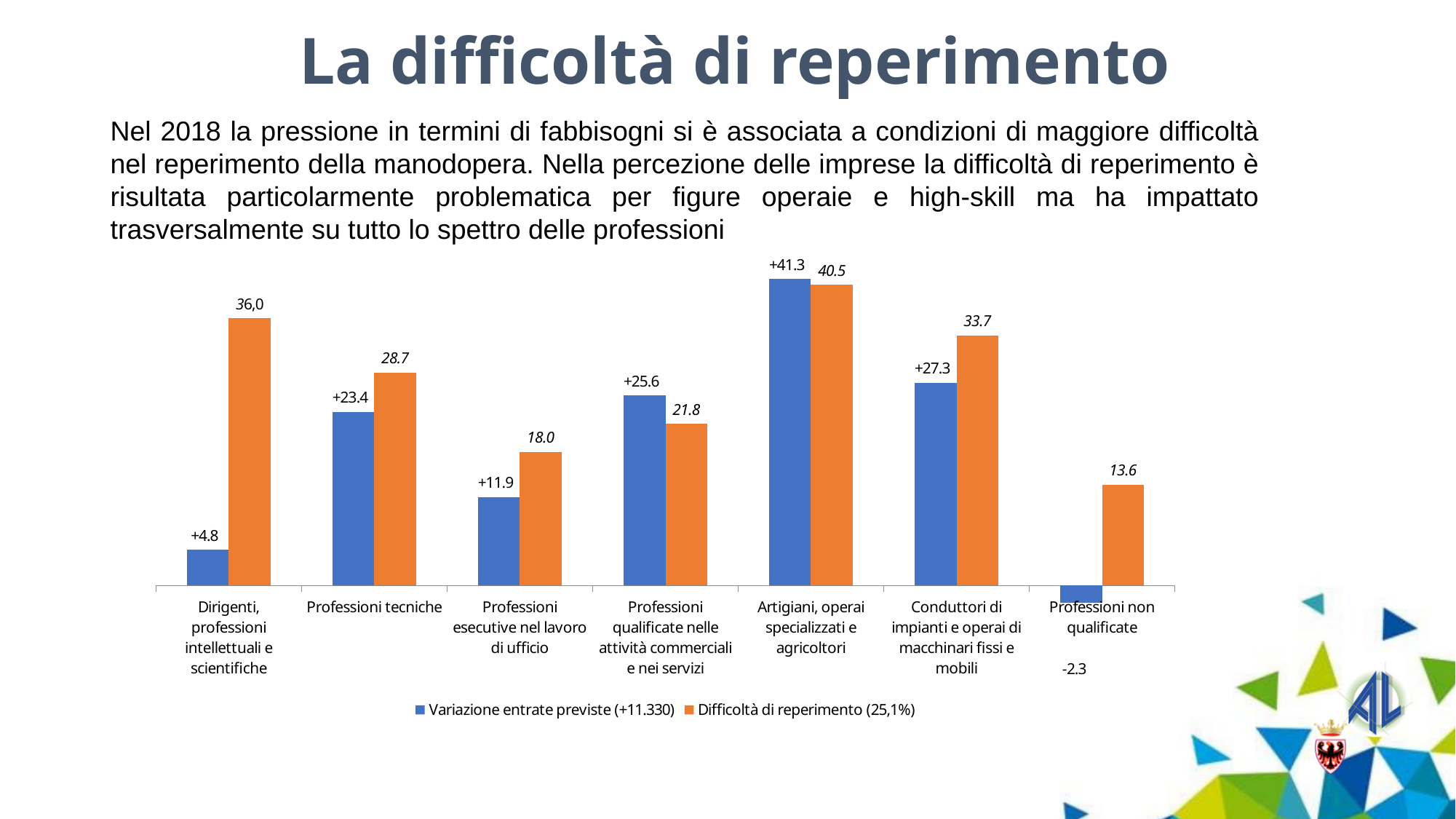
Which category has the lowest value for 'Variazione entrate previste'? Professioni non qualificate For 'Professioni qualificate nelle attività commerciali e nei servizi', which is larger: 'Variazione entrate previste' or 'Difficoltà di reperimento'? Variazione entrate previste What is the value of 'Variazione entrate previste' for 'Professioni non qualificate'? -2.3 What is the value of 'Difficoltà di reperimento' for 'Dirigenti, professioni intellettuali e scientifiche'? 36,0 What is the value of 'Difficoltà di reperimento' for 'Professioni esecutive nel lavoro di ufficio'? 18.0 What kind of chart is shown on the slide? bar chart Which category has the highest value for 'Difficoltà di reperimento'? Artigiani, operai specializzati e agricoltori What is the difference between 'Difficoltà di reperimento' and 'Variazione entrate previste' for 'Conduttori di impianti e operai di macchinari fissi e mobili'? 6.4 What is the value of 'Variazione entrate previste' for 'Professioni tecniche'? +23.4 How many occupational categories are shown on the x axis? 7 How many series does the legend list? 2 What colour are the bars for the 'Difficoltà di reperimento (25,1%)' series? orange